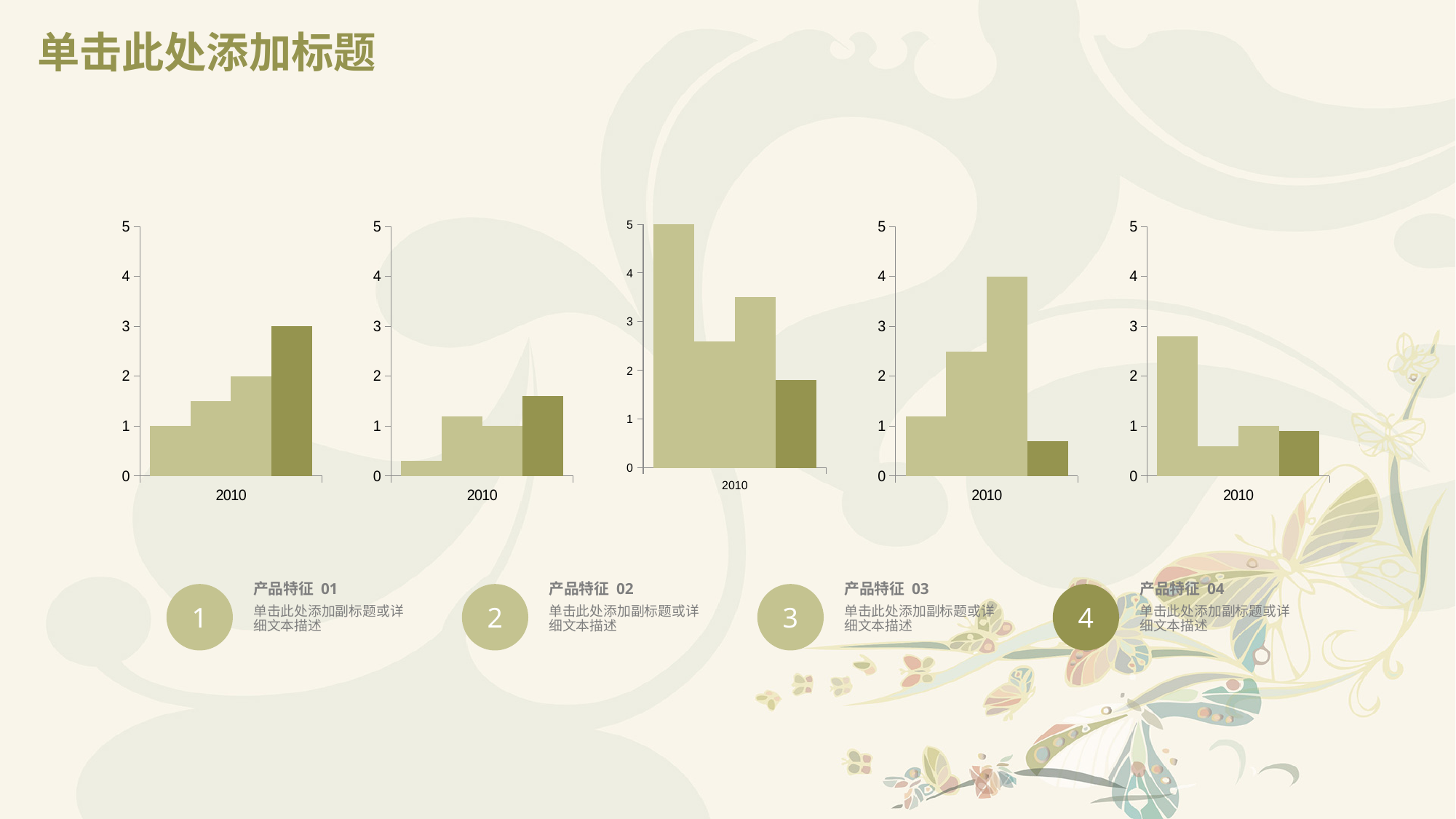
How many bars does the leftmost chart show? 4 In the leftmost chart, is the value of the fourth (darkest) bar greater or less than 2? greater In the fourth chart from the left, which bar is the shortest? the fourth (darkest) bar In the second chart from the left, is the value of the first bar greater or less than 1? less In the leftmost chart, which bar is the tallest? the fourth (darkest) bar In the fourth chart from the left, is the value of the third bar greater or less than 3? greater In the middle chart, which bar is the tallest? the first bar What category label appears on the x axis of each chart? 2010 In the middle chart, which is taller, the first bar or the fourth (darkest) bar? the first bar What kind of chart is the leftmost chart on the slide? bar chart